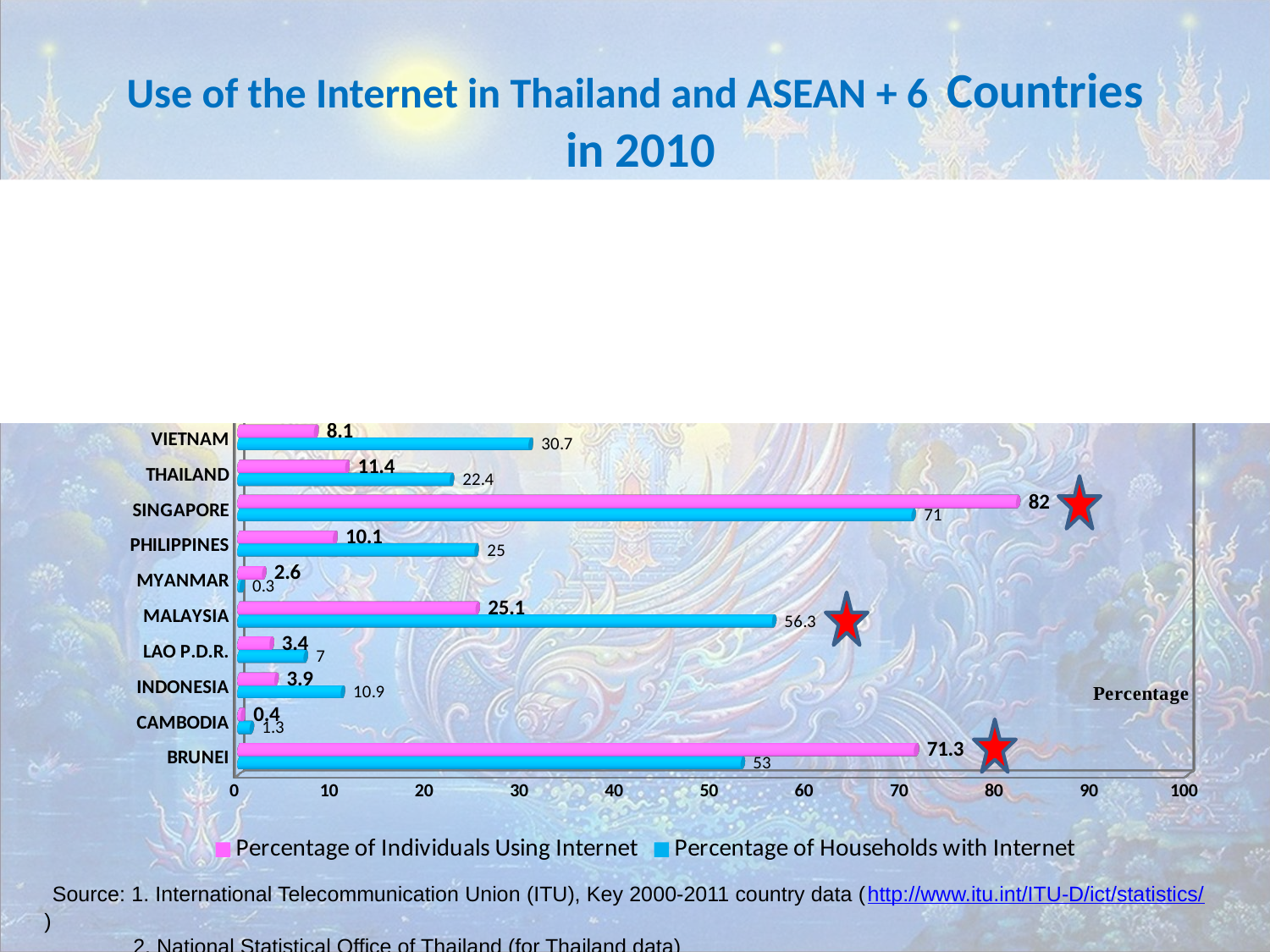
What type of chart is shown on the slide? Bar chart What is the Percentage of Households with Internet for Malaysia? 56.3 Which is larger for Vietnam: the Percentage of Individuals Using Internet or the Percentage of Households with Internet? Percentage of Households with Internet How many countries are shown in the chart? 10 Which colour represents the Percentage of Individuals Using Internet series? Pink What is the Percentage of Individuals Using Internet for Singapore? 82 What is the difference between the Percentage of Individuals Using Internet and the Percentage of Households with Internet for Brunei? 18.3 Which country has the lowest Percentage of Households with Internet? Myanmar How many series does the legend list? 2 Which country has the highest Percentage of Individuals Using Internet? Singapore What is the Percentage of Households with Internet for Thailand? 22.4 Is the Percentage of Households with Internet for Singapore greater or less than 60? greater